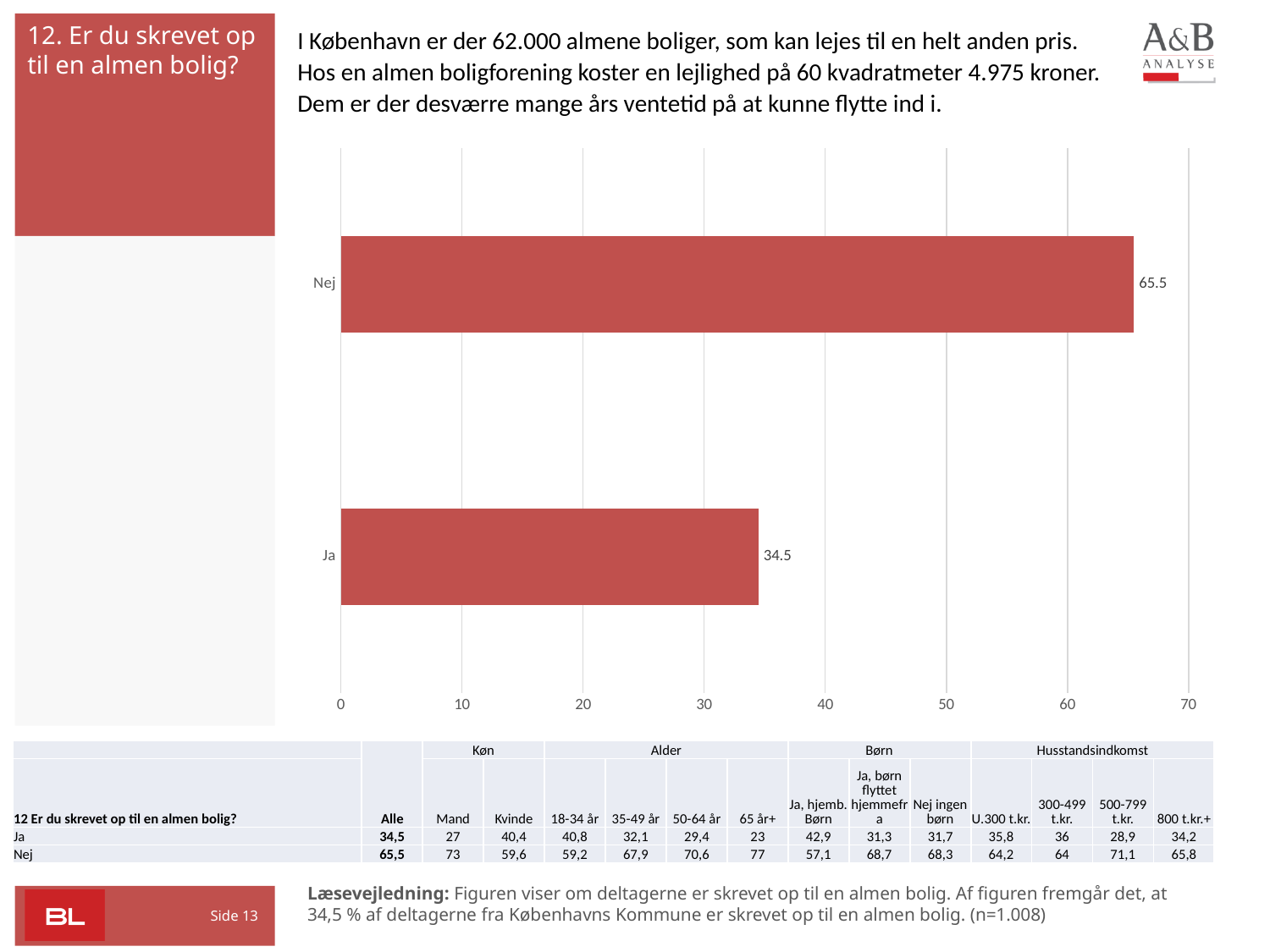
What is the highest tick value shown on the horizontal axis of the bar chart? 70 How many categories are shown in the bar chart? 2 What is the difference between the values for "Nej" and "Ja" in the bar chart? 31 What is the value shown for "Nej" in the bar chart? 65.5 Which category has the lowest value in the bar chart? Ja What kind of chart is shown on the slide? bar chart What is the value shown for "Ja" in the bar chart? 34.5 Is the value for "Ja" in the bar chart greater or less than 40? less Which category has the highest value in the bar chart? Nej Which is larger in the bar chart, the value for "Ja" or the value for "Nej"? Nej What colour are the bars in the chart? red Is the value for "Nej" in the bar chart greater or less than 60? greater